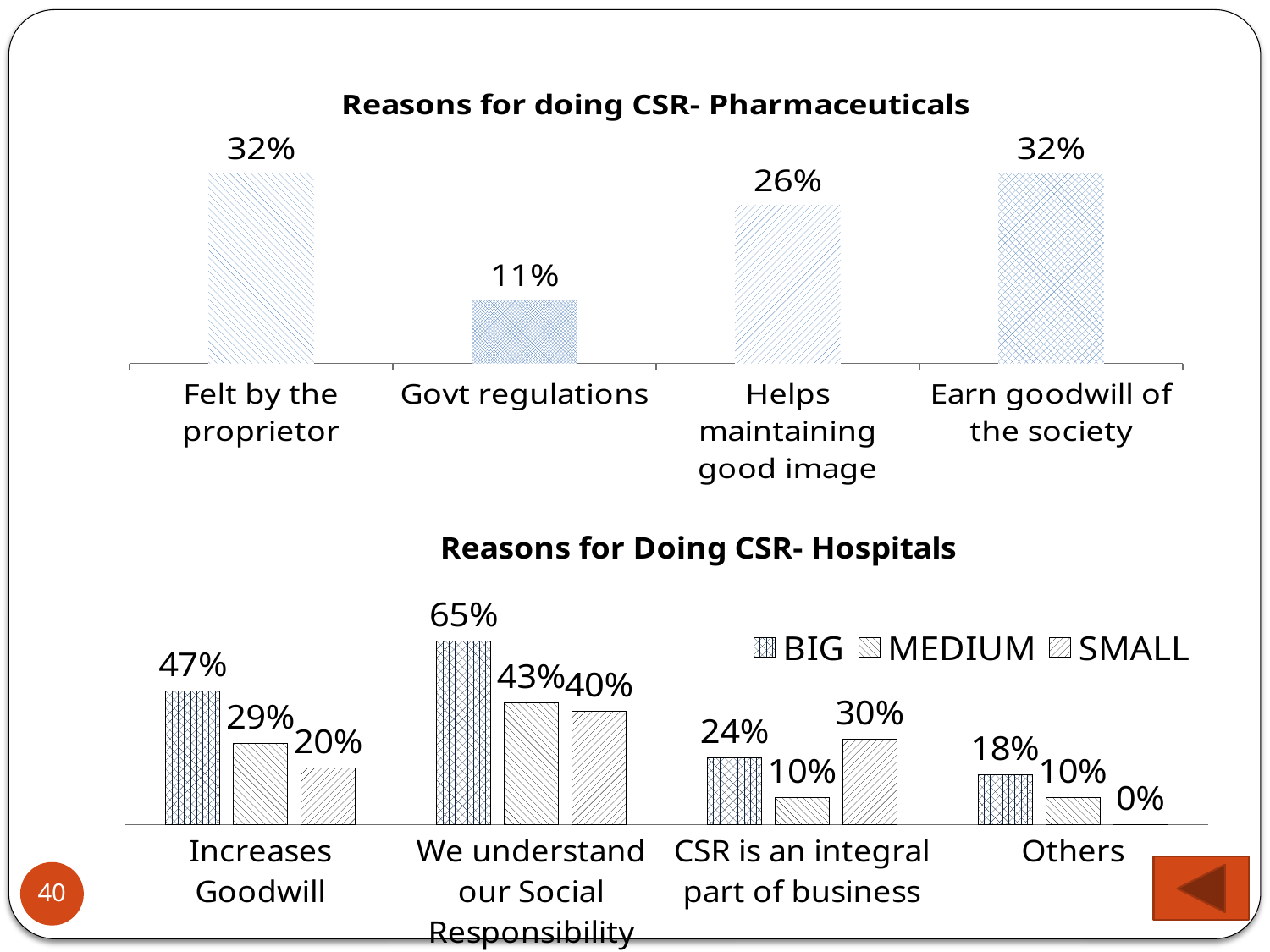
How many categories are shown in the 'Reasons for doing CSR- Pharmaceuticals' chart? 4 In the 'Reasons for Doing CSR- Hospitals' chart, what is the BIG value for We understand our Social Responsibility? 65% In the 'Reasons for Doing CSR- Hospitals' chart, what is the MEDIUM value for Increases Goodwill? 29% In the 'Reasons for doing CSR- Pharmaceuticals' chart, which category has the lowest value? Govt regulations In the 'Reasons for doing CSR- Pharmaceuticals' chart, what is the value for Helps maintaining good image? 26% How many series does the legend list in the 'Reasons for Doing CSR- Hospitals' chart? 3 In the 'Reasons for Doing CSR- Hospitals' chart, what is the difference between the BIG and SMALL values for Increases Goodwill? 27% In the 'Reasons for doing CSR- Pharmaceuticals' chart, what is the value for Govt regulations? 11% In the 'Reasons for Doing CSR- Hospitals' chart, what is the SMALL value for CSR is an integral part of business? 30% In the 'Reasons for Doing CSR- Hospitals' chart, which is larger for CSR is an integral part of business: BIG or SMALL? SMALL In the 'Reasons for doing CSR- Pharmaceuticals' chart, what is the difference between Felt by the proprietor and Govt regulations? 21% What kind of chart is 'Reasons for Doing CSR- Hospitals'? Bar chart